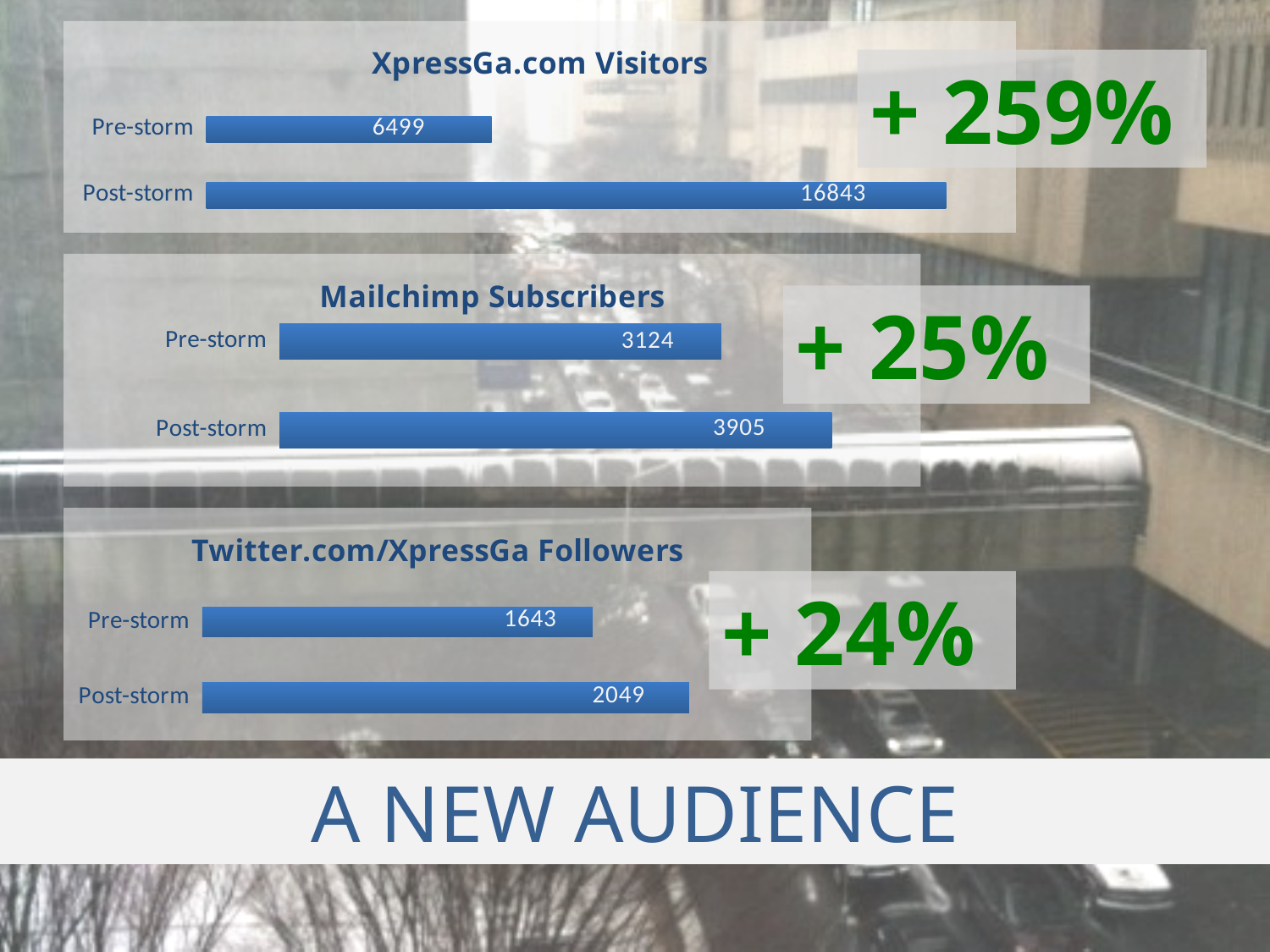
In the 'Twitter.com/XpressGa Followers' chart, which category has the lower value? Pre-storm In the 'Mailchimp Subscribers' chart, which category has the higher value? Post-storm In the 'Mailchimp Subscribers' chart, what is the value for Post-storm? 3905 In the 'Twitter.com/XpressGa Followers' chart, what is the value for Post-storm? 2049 In the 'Mailchimp Subscribers' chart, what is the value for Pre-storm? 3124 In the 'XpressGa.com Visitors' chart, what is the value for Pre-storm? 6499 In the 'Mailchimp Subscribers' chart, what is the difference between the Post-storm and Pre-storm values? 781 In the 'XpressGa.com Visitors' chart, what is the difference between the Post-storm and Pre-storm values? 10344 What kind of chart is the 'XpressGa.com Visitors' chart? Bar chart In the 'XpressGa.com Visitors' chart, what is the value for Post-storm? 16843 How many categories does the 'Twitter.com/XpressGa Followers' chart show? 2 In the 'Twitter.com/XpressGa Followers' chart, what is the value for Pre-storm? 1643